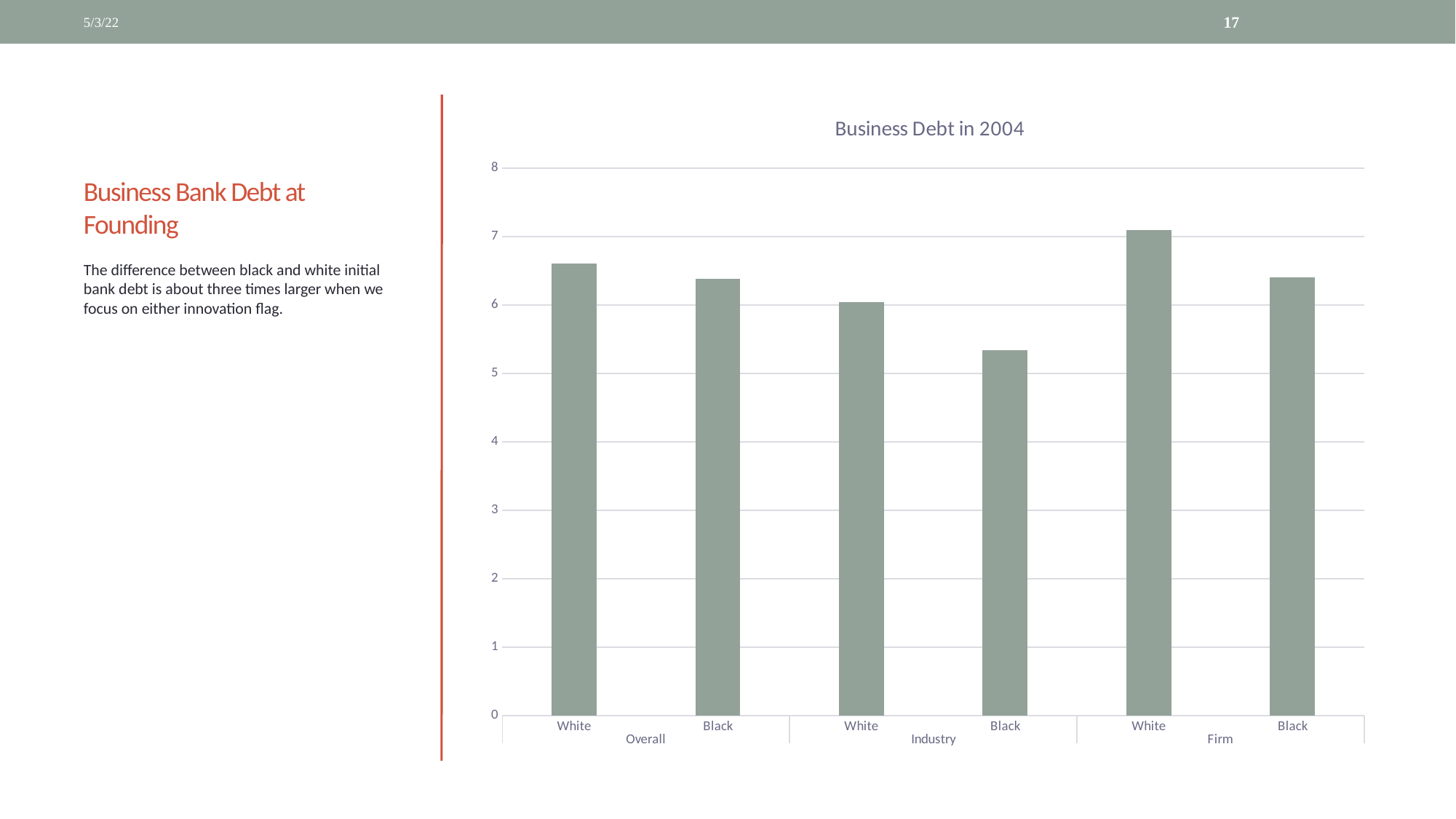
How many groups are shown along the x axis of the chart? 3 What kind of chart is shown on the slide? bar chart In the Industry group, which bar is larger, White or Black? White Is the value for White in the Overall group greater or less than 6? greater Which bar is the lowest in the chart? Black in the Industry group Is the value for White in the Firm group greater or less than 7? greater Which bar is the highest in the chart? White in the Firm group Is the value for Black in the Industry group greater or less than 6? less How many bars are plotted in the chart? 6 Which is larger, the White bar in the Firm group or the White bar in the Overall group? White in the Firm group What is the title of the chart? Business Debt in 2004